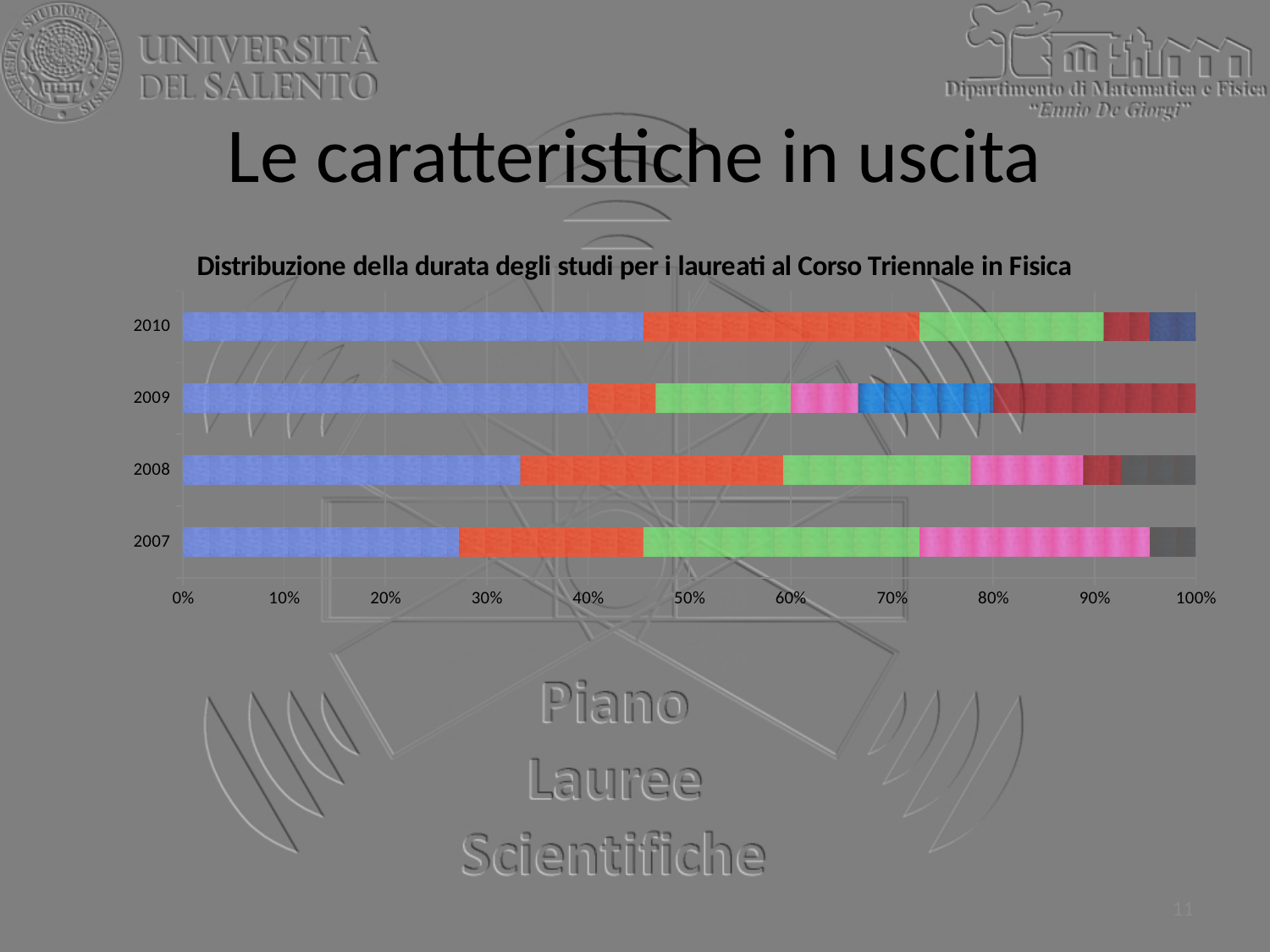
How many years (categories) are shown on the vertical axis of the chart? 4 Which year has the longer first (blue) segment, 2007 or 2010? 2010 What kind of chart is shown on the slide? Stacked bar chart Is the first (blue) segment of the 2010 bar greater or less than 40%? greater Does the first (blue) segment grow or shrink going from 2007 up to 2010? grows What is the title of the chart? Distribuzione della durata degli studi per i laureati al Corso Triennale in Fisica Which year has the shortest second (red) segment? 2009 Which year has the longest third (green) segment? 2007 Which year has the longer pink segment, 2007 or 2009? 2007 Is the first (blue) segment of the 2007 bar greater or less than 30%? less What is the maximum value shown on the horizontal axis of the chart? 100% Is the first (blue) segment of the 2008 bar greater or less than 30%? greater